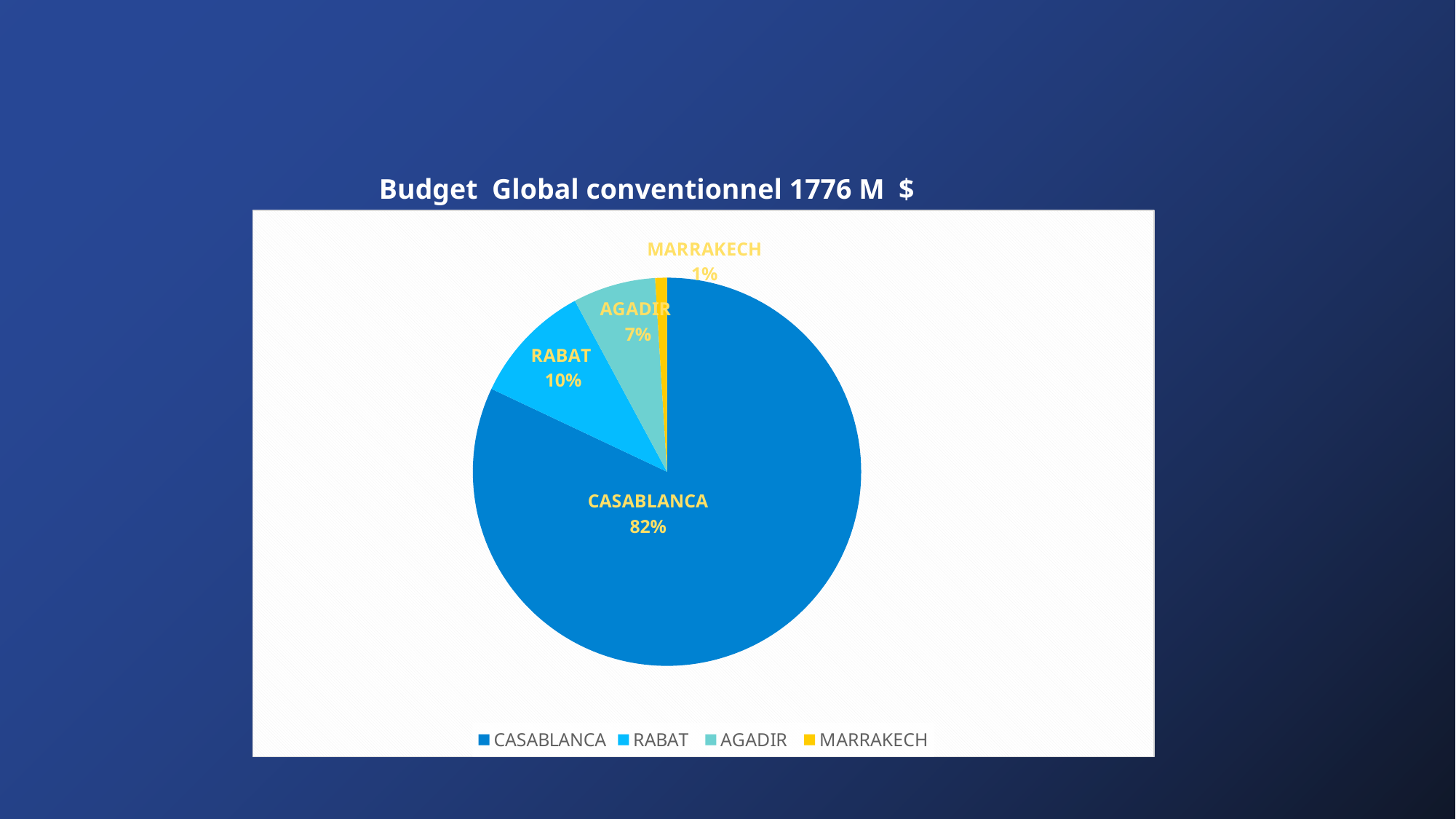
Which city has the smallest slice of the pie? MARRAKECH What is the difference in percentage points between RABAT and AGADIR? 3 What share of the pie does MARRAKECH hold? 1% Which city has the largest slice of the pie? CASABLANCA What share of the pie does CASABLANCA hold? 82% What share of the pie does AGADIR hold? 7% What is the title of the chart? Budget Global conventionnel 1776 M $ Which has a larger share, AGADIR or MARRAKECH? AGADIR How many slices does the pie chart have? 4 What kind of chart is shown on the slide? Pie chart What is the difference in percentage points between CASABLANCA and RABAT? 72